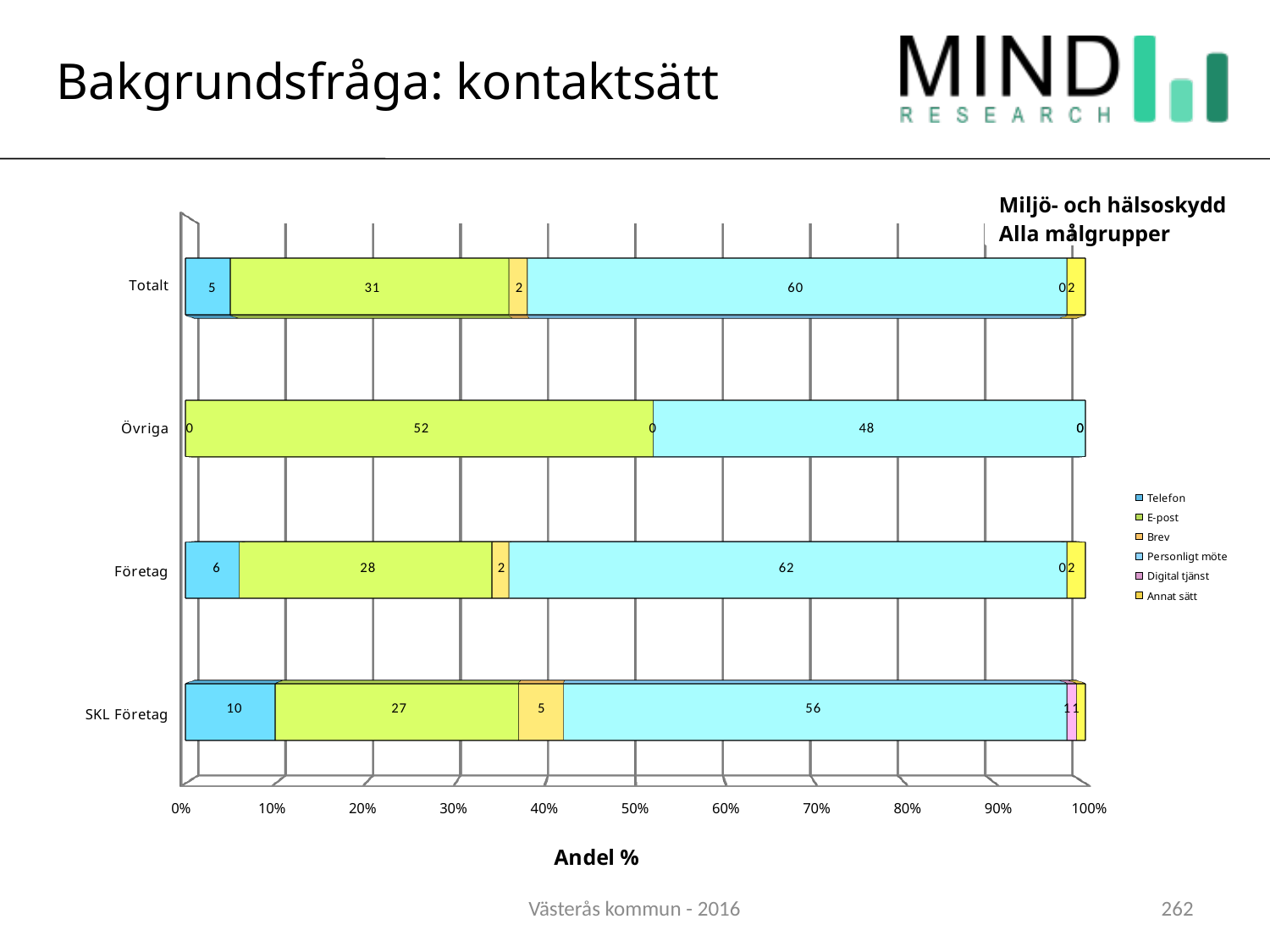
What is the label of the horizontal axis? Andel % What kind of chart is shown on the slide? Stacked bar chart Which category has the lowest value for E-post? SKL Företag What is the value for E-post in the Övriga category? 52 How many series does the legend list? 6 How many categories are shown on the vertical axis of the chart? 4 Which category has the highest value for Personligt möte? Företag What is the difference between the E-post values for Övriga and Totalt? 21 What is the value for Telefon in the SKL Företag category? 10 What is the value for Brev in the Totalt category? 2 What is the value for Personligt möte in the Företag category? 62 Which is larger, the Telefon value for Företag or for SKL Företag? SKL Företag